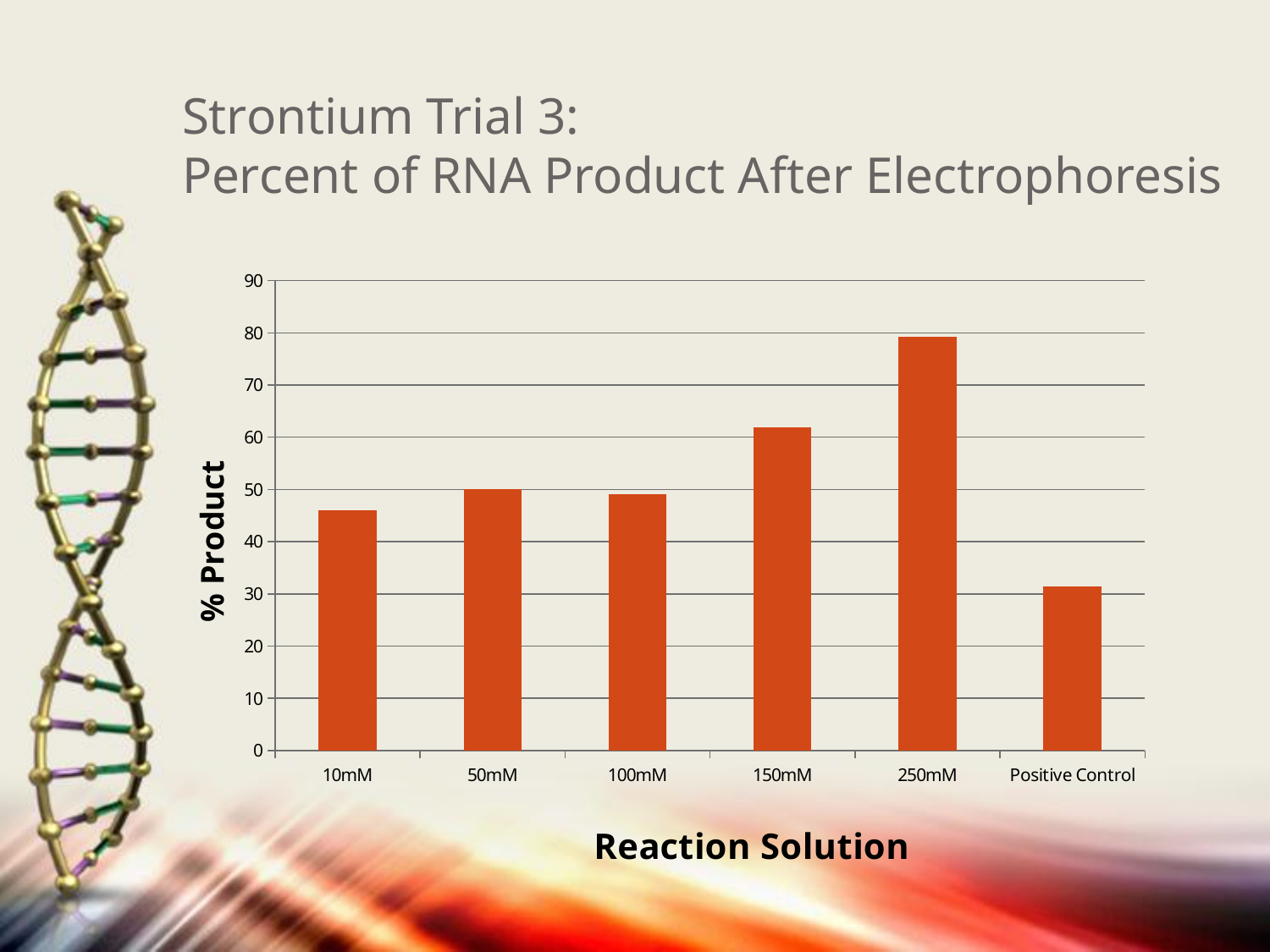
Which has a higher % Product, 250mM or Positive Control? 250mM Which reaction solution has the highest % Product? 250mM What is the label on the vertical axis? % Product Is the value for Positive Control greater or less than 40? less What kind of chart is shown on the slide? bar chart Is the value for 250mM greater or less than 70? greater How many reaction solution categories are plotted on the x axis? 6 What is the label on the horizontal axis? Reaction Solution Which has a higher % Product, 150mM or 10mM? 150mM Which reaction solution has the lowest % Product? Positive Control Is the value for 150mM greater or less than 60? greater